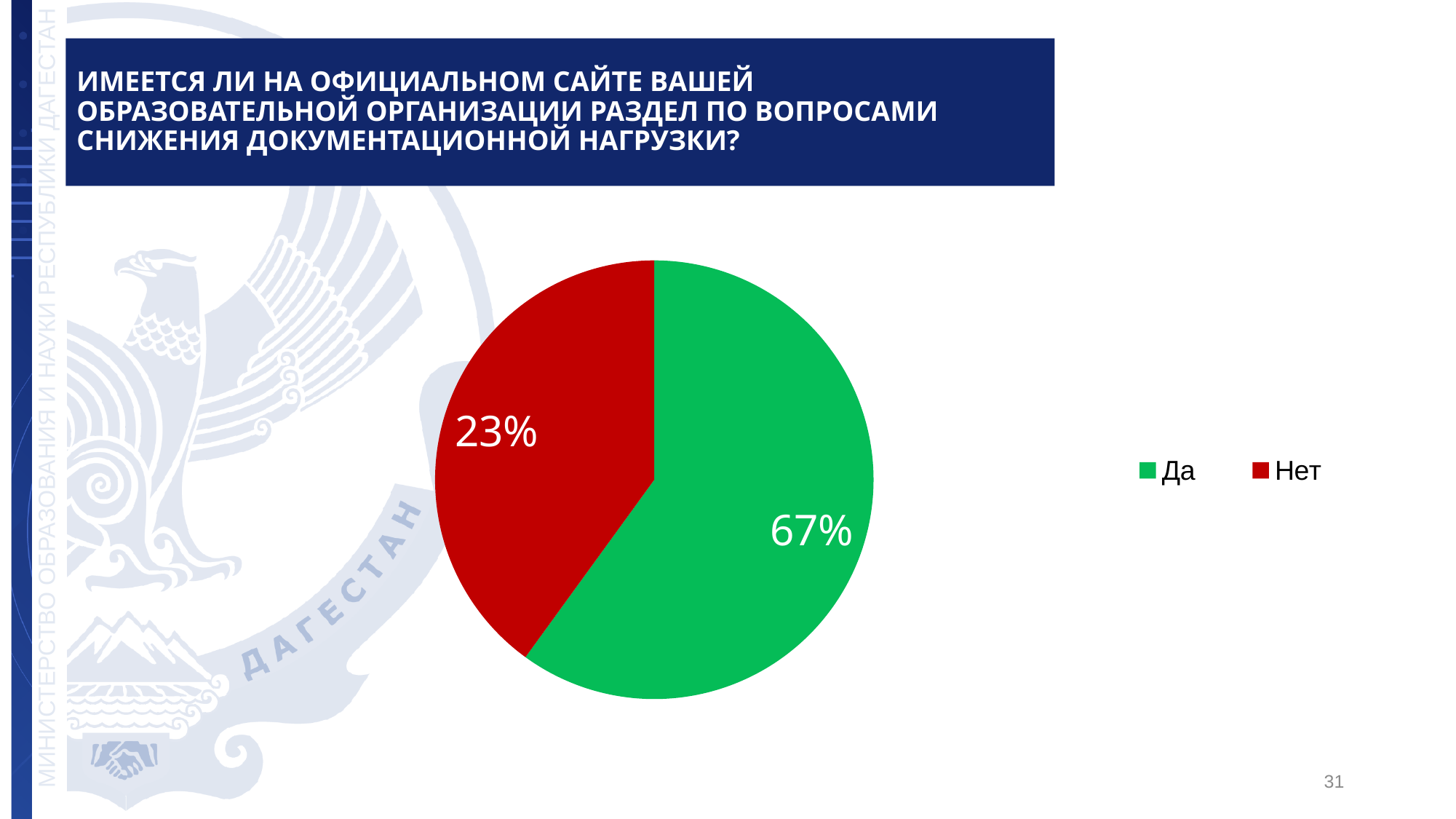
How many entries does the legend list? 2 What type of chart is shown on the slide? pie chart What percentage is shown for the "Нет" slice? 23% Which is larger, the "Да" slice or the "Нет" slice? Да What share of the pie does the "Нет" slice represent according to its label? 23% What is the difference in percentage points between the "Да" and "Нет" slices? 44 What colour is the "Да" slice in the pie chart? green What colour is the "Нет" slice in the pie chart? red Which slice is the largest in the pie chart? Да Which slice is the smallest in the pie chart? Нет How many slices does the pie chart have? 2 What percentage is shown for the "Да" slice? 67%